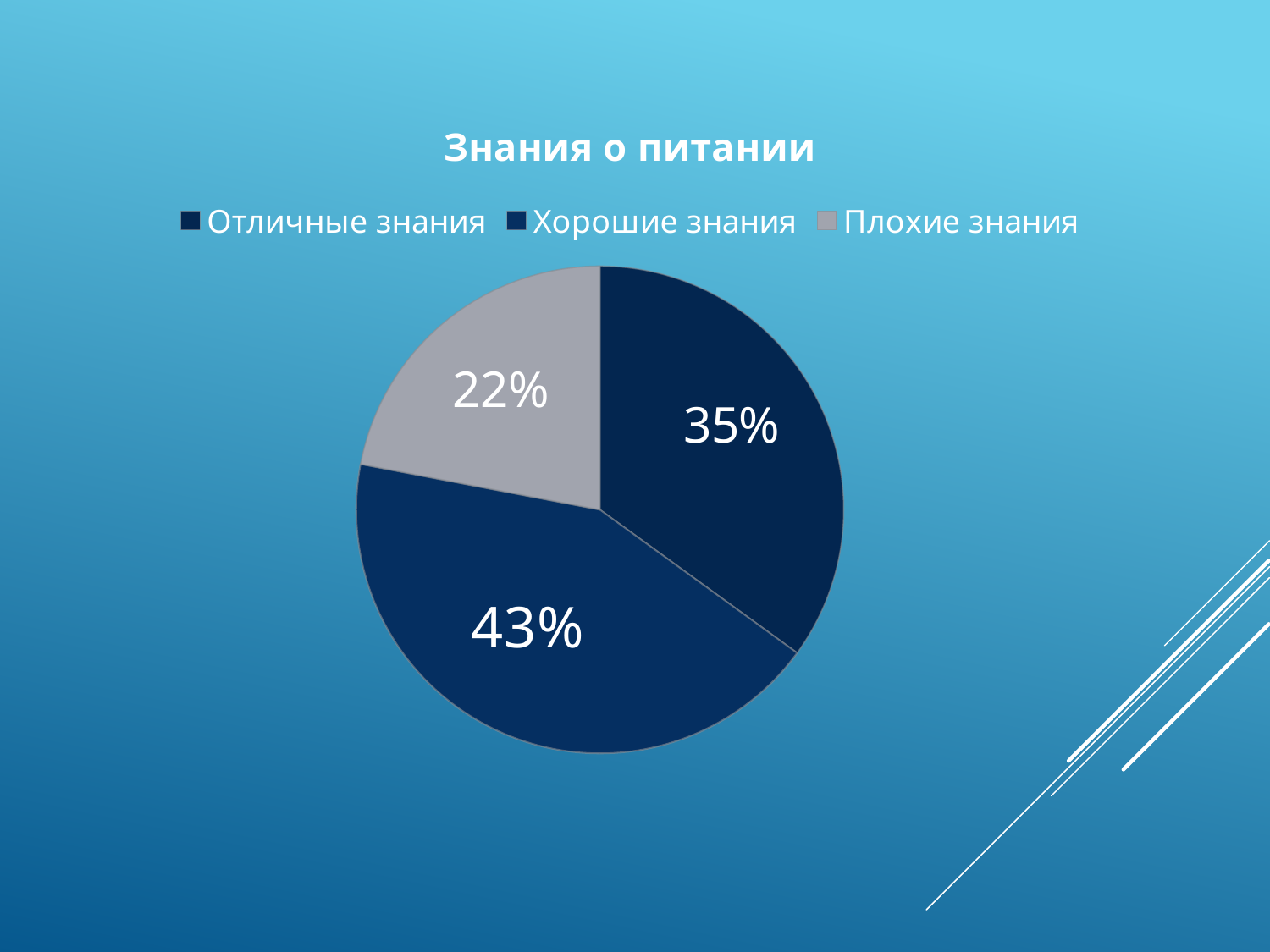
What is the difference between the shares for "Отличные знания" and "Плохие знания"? 13% What percentage of the pie is labelled "Хорошие знания"? 43% Which category has the largest share of the pie? Хорошие знания Which is larger, the share for "Отличные знания" or the share for "Плохие знания"? Отличные знания What percentage of the pie is labelled "Плохие знания"? 22% What type of chart is shown on the slide? Pie chart How many entries does the legend list? 3 Which category has the smallest share of the pie? Плохие знания How many slices does the pie chart have? 3 What is the difference between the shares for "Хорошие знания" and "Отличные знания"? 8% What percentage of the pie is labelled "Отличные знания"? 35% What is the title of the chart? Знания о питании